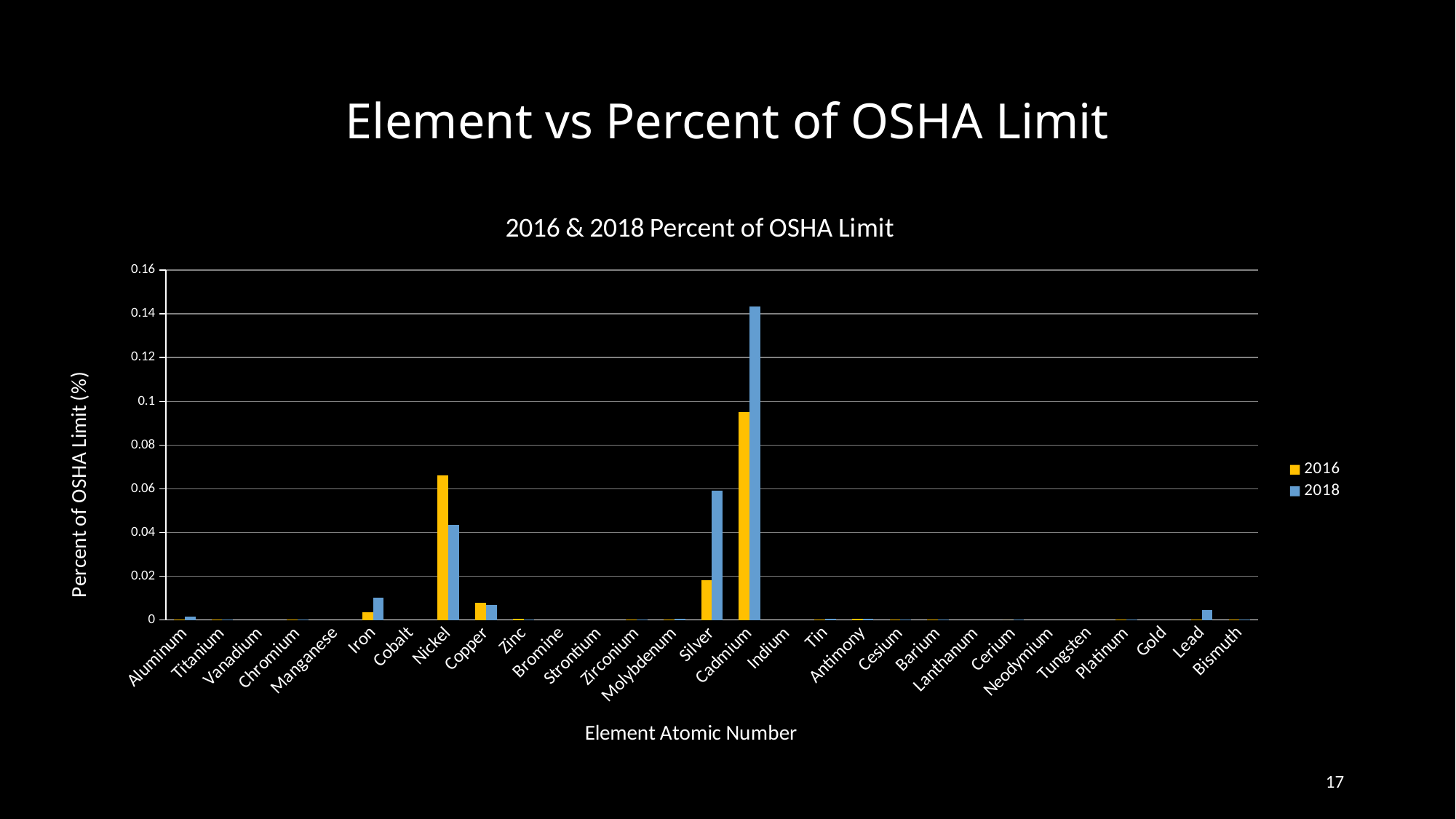
For Silver, which series has the larger value, 2016 or 2018? 2018 Is the 2018 value for Silver greater or less than 0.04? greater Is the 2018 value for Cadmium greater or less than 0.12? greater What is the label of the y axis? Percent of OSHA Limit (%) How many elements are shown along the x axis? 29 Is the 2016 value for Cadmium greater or less than 0.1? less How many series does the legend list? 2 What kind of chart is shown on the slide? bar chart For Nickel, which series has the larger value, 2016 or 2018? 2016 Which element has the highest 2018 value? Cadmium Which element has the highest 2016 value? Cadmium